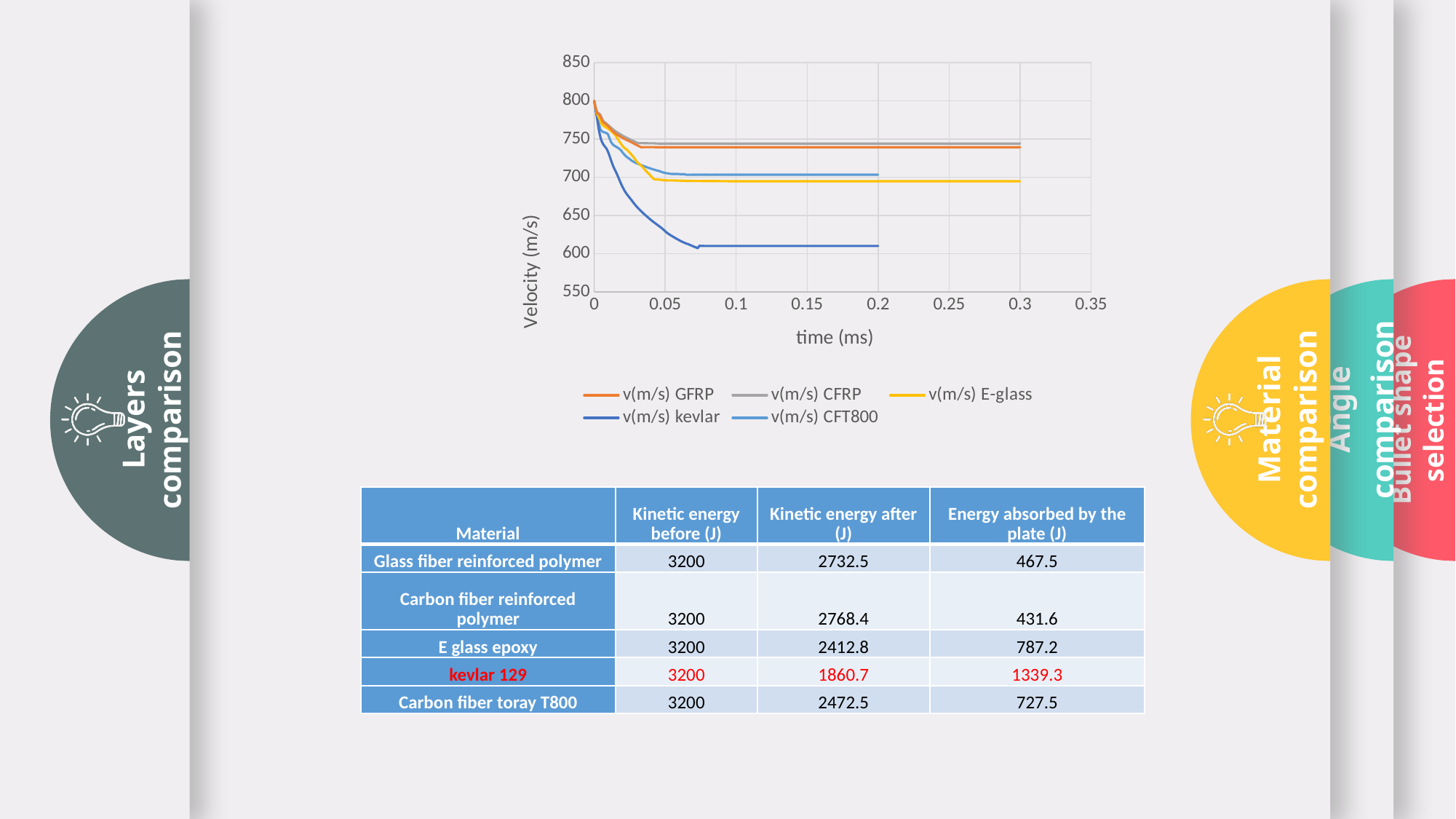
What is the label of the chart's y axis? Velocity (m/s) Which series ends at a higher velocity, kevlar or E-glass? v(m/s) E-glass How many series does the chart's legend list? 5 What kind of chart is shown on the slide? line chart Is the final velocity of the GFRP series greater or less than 700 m/s? greater Do the velocity values rise or fall as time increases along the x axis? fall Is the final velocity of the CFRP series greater or less than 800 m/s? less Which series ends at a higher velocity, CFT800 or kevlar? v(m/s) CFT800 Is the final velocity of the kevlar series greater or less than 650 m/s? less What is the label of the chart's x axis? time (ms) Which series reaches the lowest velocity on the chart? v(m/s) kevlar